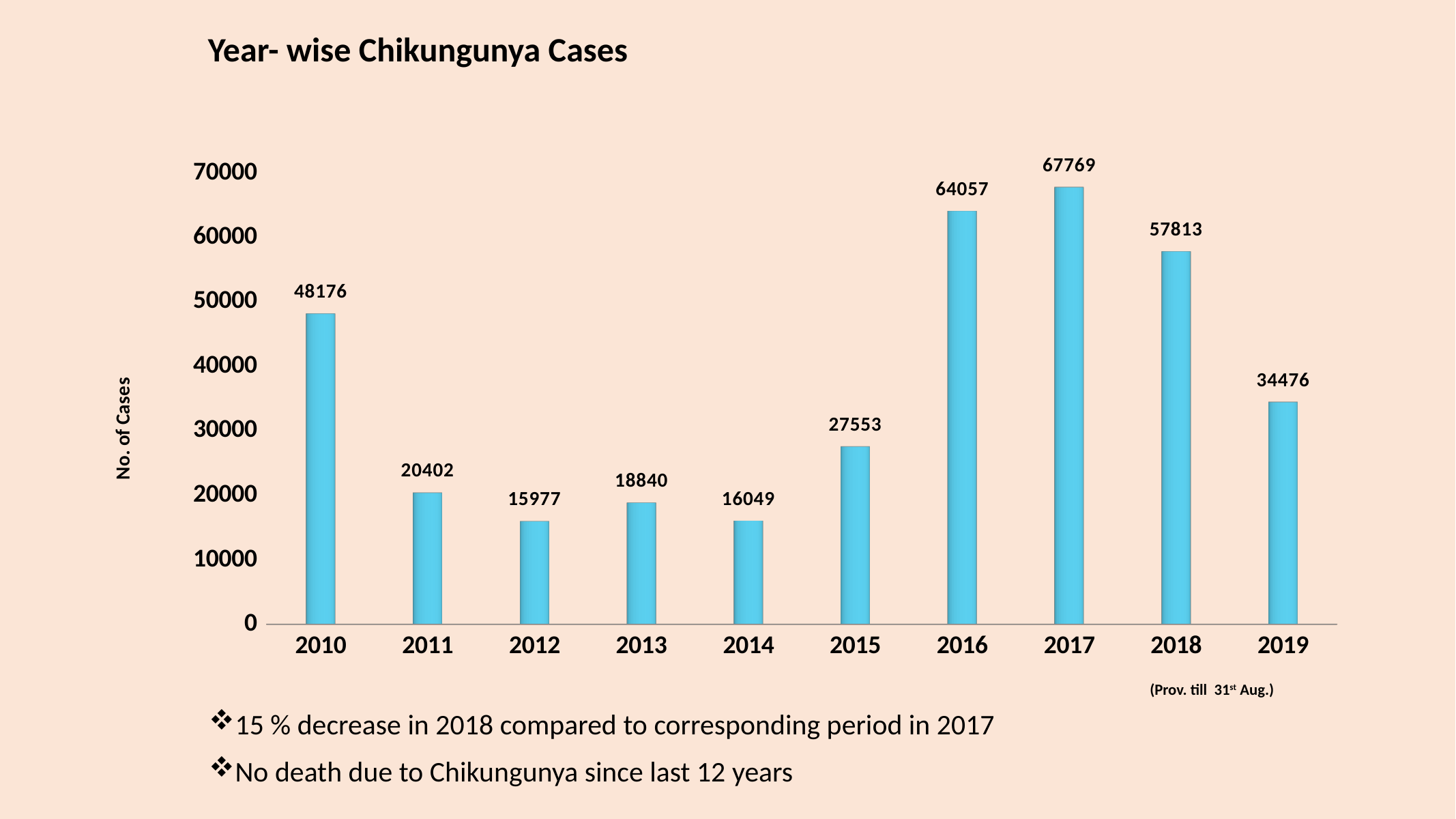
What is the difference in cases between 2017 and 2018? 9956 What is the title of the chart? Year- wise Chikungunya Cases Which year had more cases, 2010 or 2018? 2018 What is the number of Chikungunya cases in 2019? 34476 What kind of chart is shown on the slide? bar chart Which year has the lowest number of Chikungunya cases? 2012 What is the number of Chikungunya cases in 2016? 64057 What is the difference in cases between 2016 and 2015? 36504 Which year has the highest number of Chikungunya cases? 2017 Is the value for 2015 greater or less than 30000? less How many years are shown on the x axis? 10 What is the number of Chikungunya cases in 2012? 15977